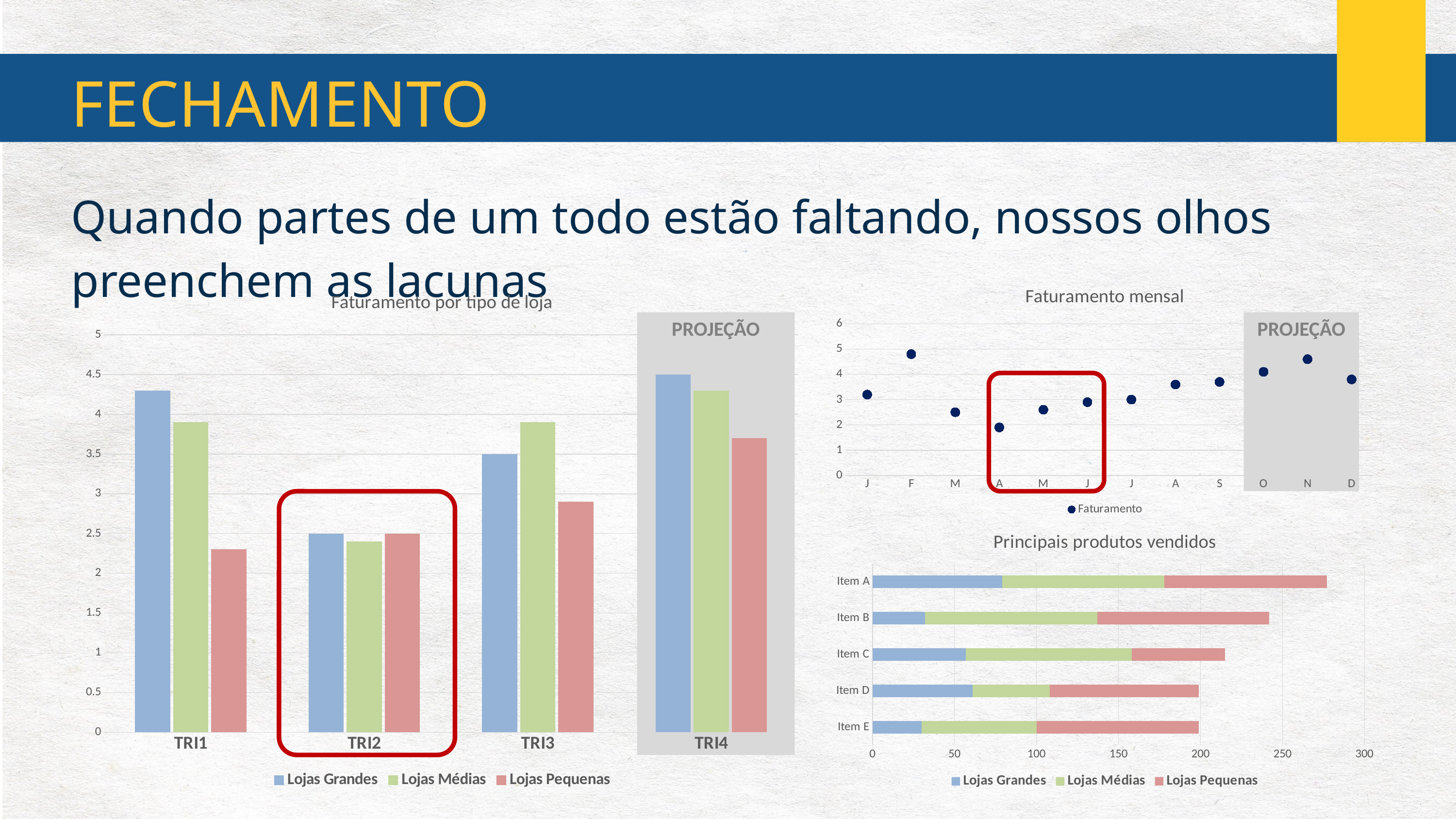
In the 'Principais produtos vendidos' chart, how many items are listed on the vertical axis? 5 What kind of chart is 'Faturamento por tipo de loja'? bar chart In the 'Faturamento por tipo de loja' chart, is the value for Lojas Grandes in TRI1 greater or less than 4? greater In the 'Faturamento por tipo de loja' chart, is the value for Lojas Pequenas in TRI2 greater or less than 3? less In the 'Faturamento mensal' chart, how many data points are plotted? 12 In the 'Principais produtos vendidos' chart, which item has the longest total bar? Item A In the 'Faturamento por tipo de loja' chart, how many quarter categories are shown on the x axis? 4 In the 'Faturamento mensal' chart, is the value for M (March) greater or less than 3? less In the 'Faturamento por tipo de loja' chart, in which quarter is Lojas Grandes highest? TRI4 In the 'Faturamento por tipo de loja' chart, which is larger for Lojas Grandes: TRI1 or TRI3? TRI1 In the 'Faturamento mensal' chart, which month has the lowest value? A In the 'Faturamento por tipo de loja' chart, how many series does the legend list? 3